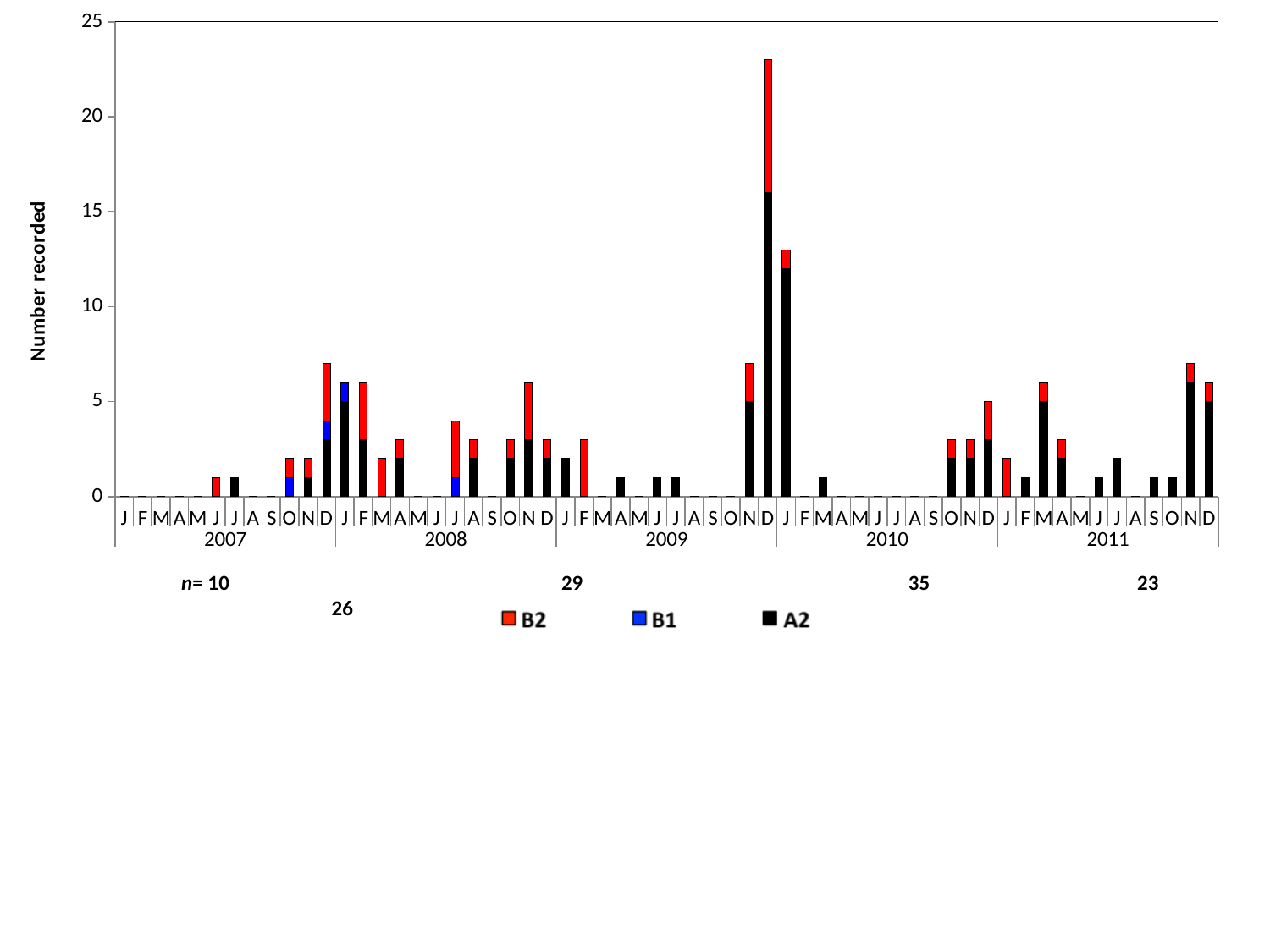
What are the series names listed in the legend? B2, B1, A2 Is the total for January 2010 greater or less than 10? greater Is the total for December 2009 greater or less than 20? greater What is the n value printed for 2010? 35 Which year has the highest printed n value? 2010 In which month and year is the tallest bar? December 2009 What is the label on the vertical axis? Number recorded What kind of chart is shown on the slide? Stacked bar chart What is the n value printed for 2007? 10 How many series does the legend list? 3 Which bar is taller, December 2009 or January 2010? December 2009 Is the total for December 2007 greater or less than 5? greater